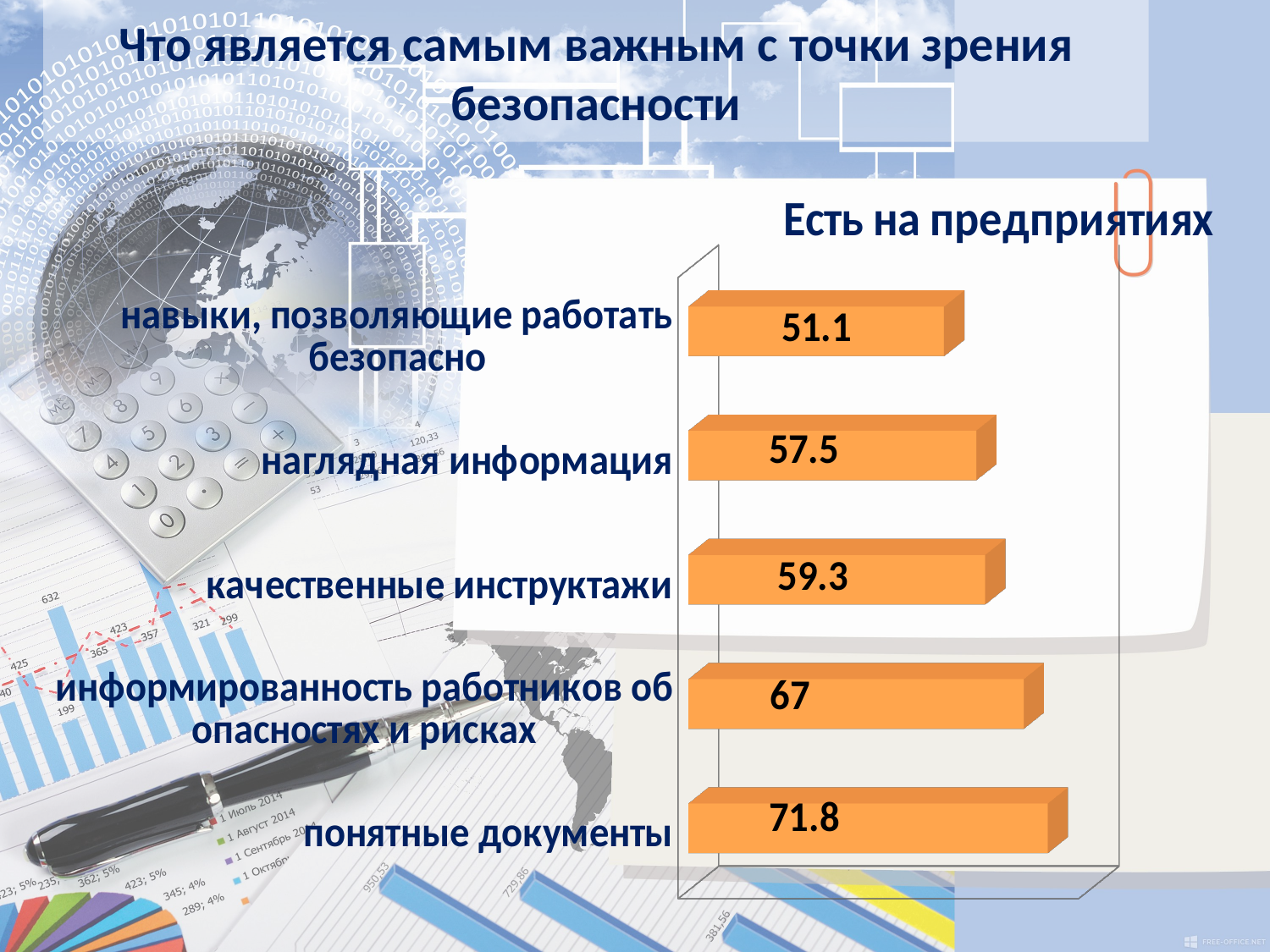
What is the value for «наглядная информация»? 57.5 What is the value for «понятные документы»? 71.8 Which is larger: the value for «наглядная информация» or for «качественные инструктажи»? качественные инструктажи What is the difference between the values for «понятные документы» and «навыки, позволяющие работать безопасно»? 20.7 What is the value for «информированность работников об опасностях и рисках»? 67 What is the title of the chart? Есть на предприятиях How many categories are shown in the chart? 5 Which category has the highest value? понятные документы Which category has the lowest value? навыки, позволяющие работать безопасно What is the value for «качественные инструктажи»? 59.3 What is the difference between the values for «информированность работников об опасностях и рисках» and «качественные инструктажи»? 7.7 What kind of chart is shown on the slide? bar chart